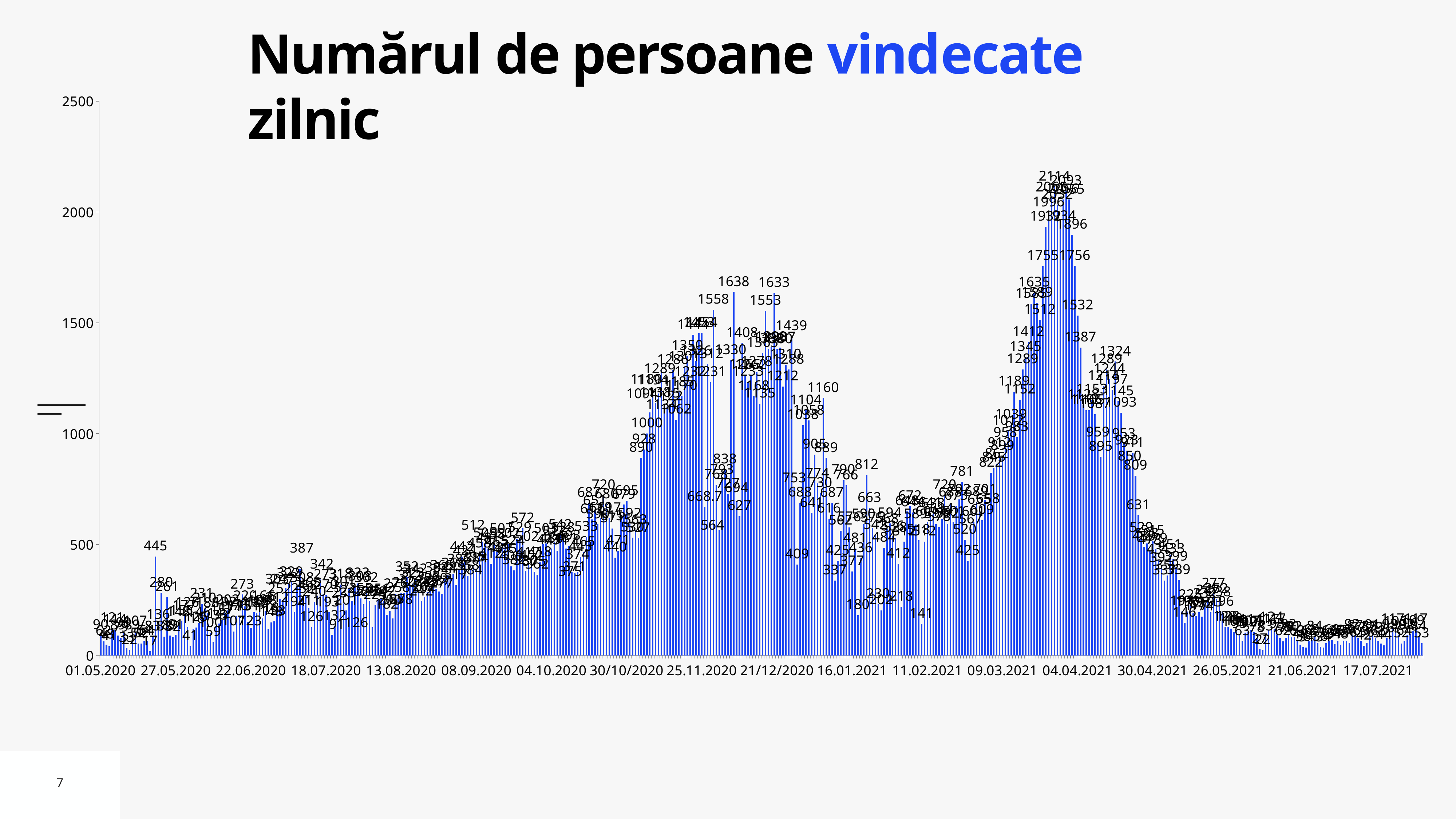
What is the maximum value shown on the y axis? 2500 What is the value of the tallest bar near 18.07.2020? 387 What kind of chart is shown on the slide? bar chart What is the title of the chart? Numărul de persoane vindecate zilnic Is the value for 21.06.2021 greater or less than 500? less Is the value for 01.05.2020 greater or less than 500? less What is the value of the tallest bar in the first peak near 27.05.2020? 445 Which is larger: the peak value around 25.11.2020 (1638) or the peak value around 04.04.2021 (2114)? 2114 (around 04.04.2021) What is the difference between the peak value 445 (late May 2020) and the peak value 387 (mid July 2020)? 58 Do the values rise or fall between 09.03.2021 and 04.04.2021? rise What is the difference between the highest labeled value (2114) and the highest labeled value of the late-2020 peak (1638)? 476 What is the highest value labeled on the chart? 2114